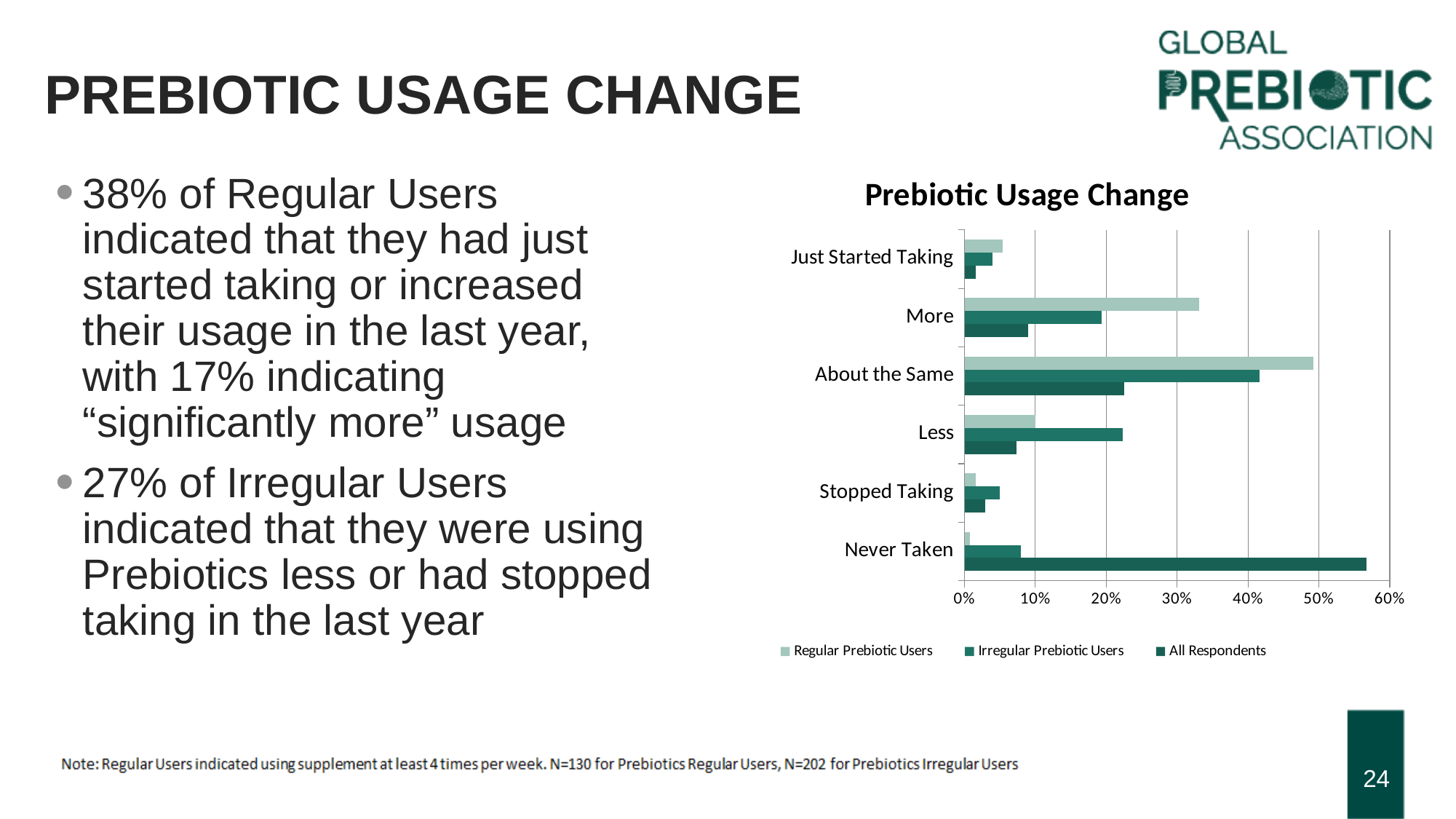
In the Less category, which is larger: Regular Prebiotic Users or Irregular Prebiotic Users? Irregular Prebiotic Users Which category has the highest value for All Respondents? Never Taken Is the value for All Respondents in the Never Taken category greater or less than 50%? greater Is the value for Regular Prebiotic Users in the About the Same category greater or less than 40%? greater How many series does the chart's legend list? 3 What kind of chart is shown on the slide? Bar chart Which category has the highest value for Regular Prebiotic Users? About the Same Is the value for Regular Prebiotic Users in the More category greater or less than 30%? greater In the More category, which is larger: Regular Prebiotic Users or Irregular Prebiotic Users? Regular Prebiotic Users How many categories are shown on the chart's vertical axis? 6 What is the title of the chart? Prebiotic Usage Change